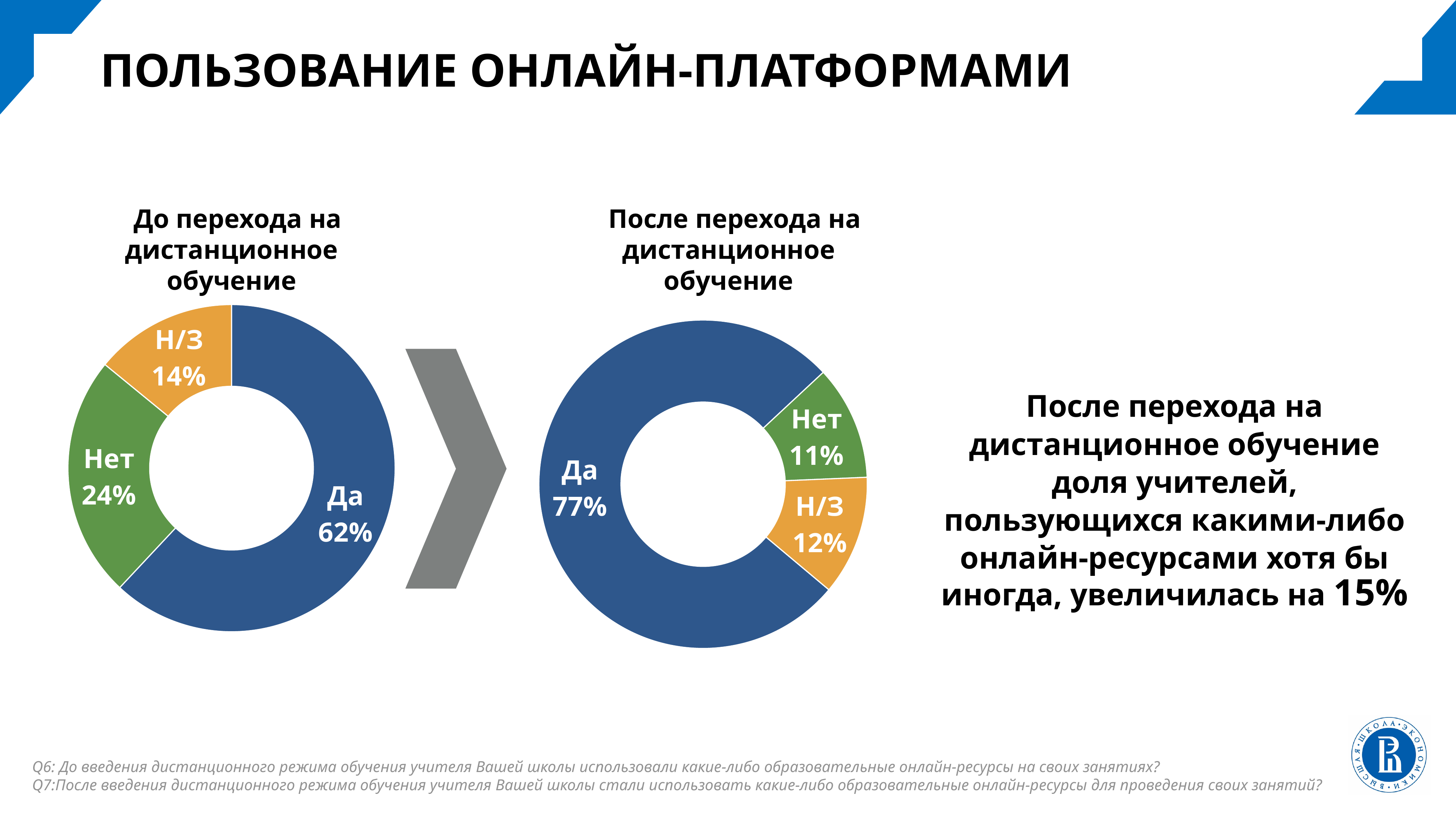
In the chart titled "После перехода на дистанционное обучение", what is the value for "Да"? 77% In the chart titled "После перехода на дистанционное обучение", which category has the smallest share? Нет What is the difference between the "Да" value in the chart titled "После перехода на дистанционное обучение" and the "Да" value in the chart titled "До перехода на дистанционное обучение"? 15% In the chart titled "После перехода на дистанционное обучение", what is the value for "Н/З"? 12% In the chart titled "До перехода на дистанционное обучение", what is the value for "Нет"? 24% In the chart titled "До перехода на дистанционное обучение", which category has the largest share? Да How many categories does the chart titled "После перехода на дистанционное обучение" show? 3 Which is larger: "Нет" in the chart titled "До перехода на дистанционное обучение" or "Нет" in the chart titled "После перехода на дистанционное обучение"? Нет in До перехода на дистанционное обучение In the chart titled "До перехода на дистанционное обучение", what is the value for "Да"? 62% In the chart titled "До перехода на дистанционное обучение", what is the difference between "Нет" and "Н/З"? 10% In the chart titled "До перехода на дистанционное обучение", which category has the smallest share? Н/З What kind of chart is the chart titled "До перехода на дистанционное обучение"? Doughnut (pie) chart